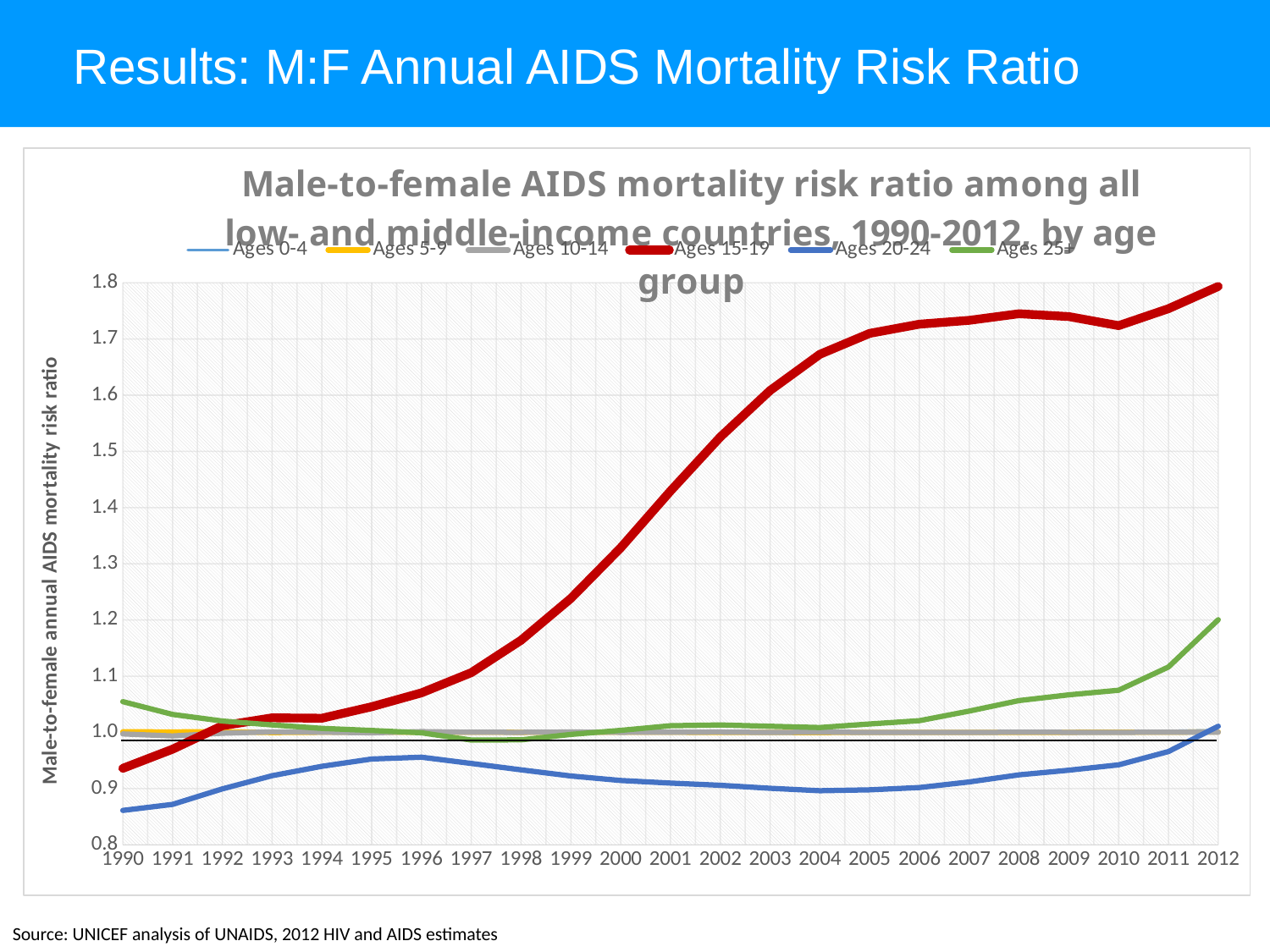
Is the value for Ages 20-24 in 1990 greater or less than 0.9? less What is the title of the y axis? Male-to-female annual AIDS mortality risk ratio Which age group has the lowest value in 2004? Ages 20-24 Does the value for Ages 15-19 rise or fall from 1990 to 2012? rise Is the value for Ages 25+ in 2012 greater or less than 1.1? greater How many years are plotted along the x axis? 23 What kind of chart is shown on the slide? line chart Is the value for Ages 15-19 in 1990 greater or less than 1.0? less In 2012, which is larger: the value for Ages 15-19 or the value for Ages 25+? Ages 15-19 How many series does the legend list? 6 Which age group has the highest value in 2012? Ages 15-19